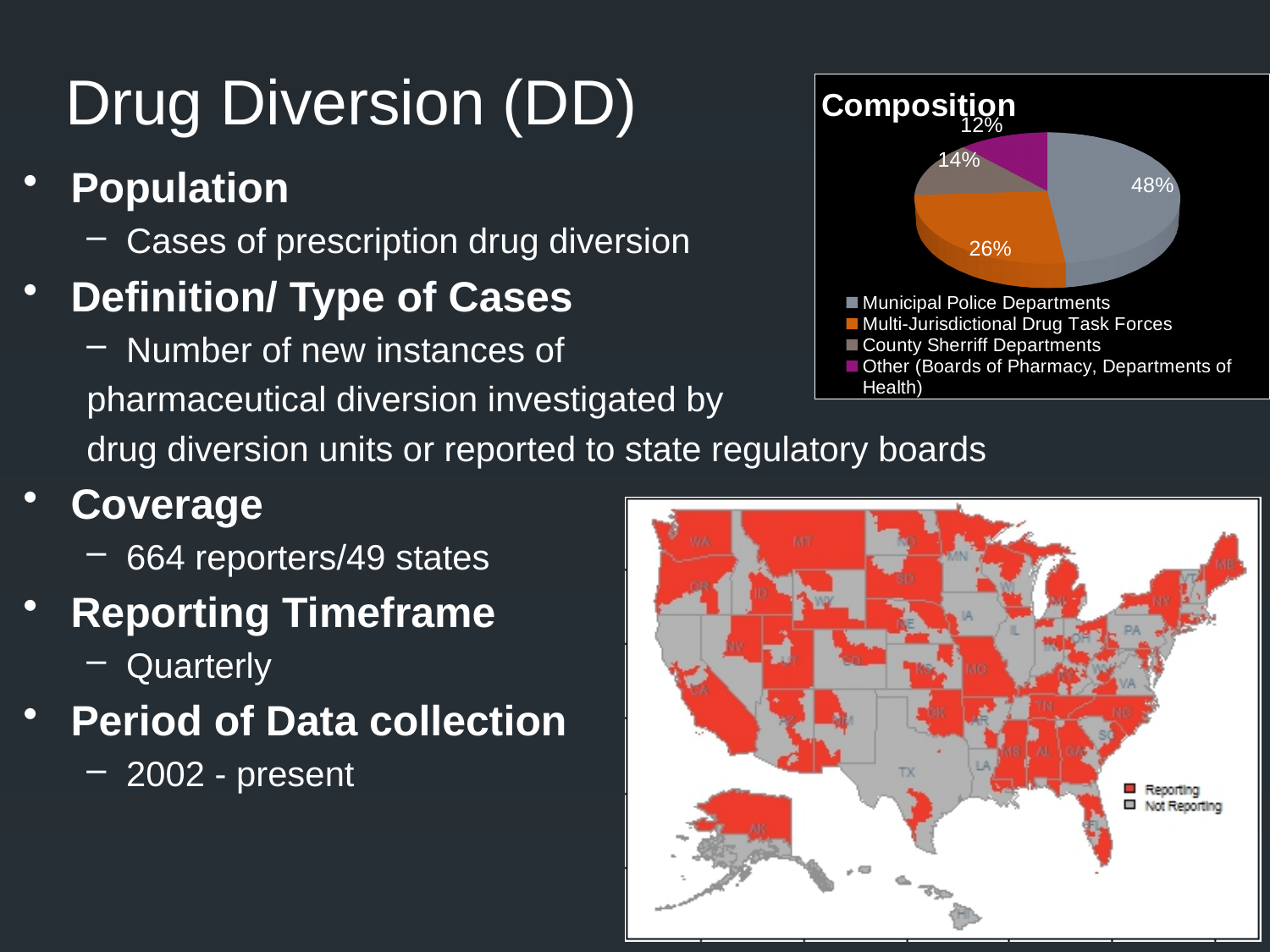
In the "Composition" pie chart, what share is Municipal Police Departments? 48% In the "Composition" pie chart, what share is Other (Boards of Pharmacy, Departments of Health)? 12% In the "Composition" pie chart, which category has the smallest share? Other (Boards of Pharmacy, Departments of Health) In the "Composition" pie chart, what share is County Sherriff Departments? 14% What kind of chart is the "Composition" chart? pie chart In the "Composition" pie chart, what is the difference in percentage points between Municipal Police Departments and Multi-Jurisdictional Drug Task Forces? 22 percentage points In the "Composition" pie chart, which is larger: County Sherriff Departments or Multi-Jurisdictional Drug Task Forces? Multi-Jurisdictional Drug Task Forces In the "Composition" pie chart, what colour is the Multi-Jurisdictional Drug Task Forces slice? orange How many entries does the legend of the "Composition" pie chart list? 4 In the "Composition" pie chart, what share is Multi-Jurisdictional Drug Task Forces? 26% In the "Composition" pie chart, which category has the largest share? Municipal Police Departments How many slices does the "Composition" pie chart have? 4